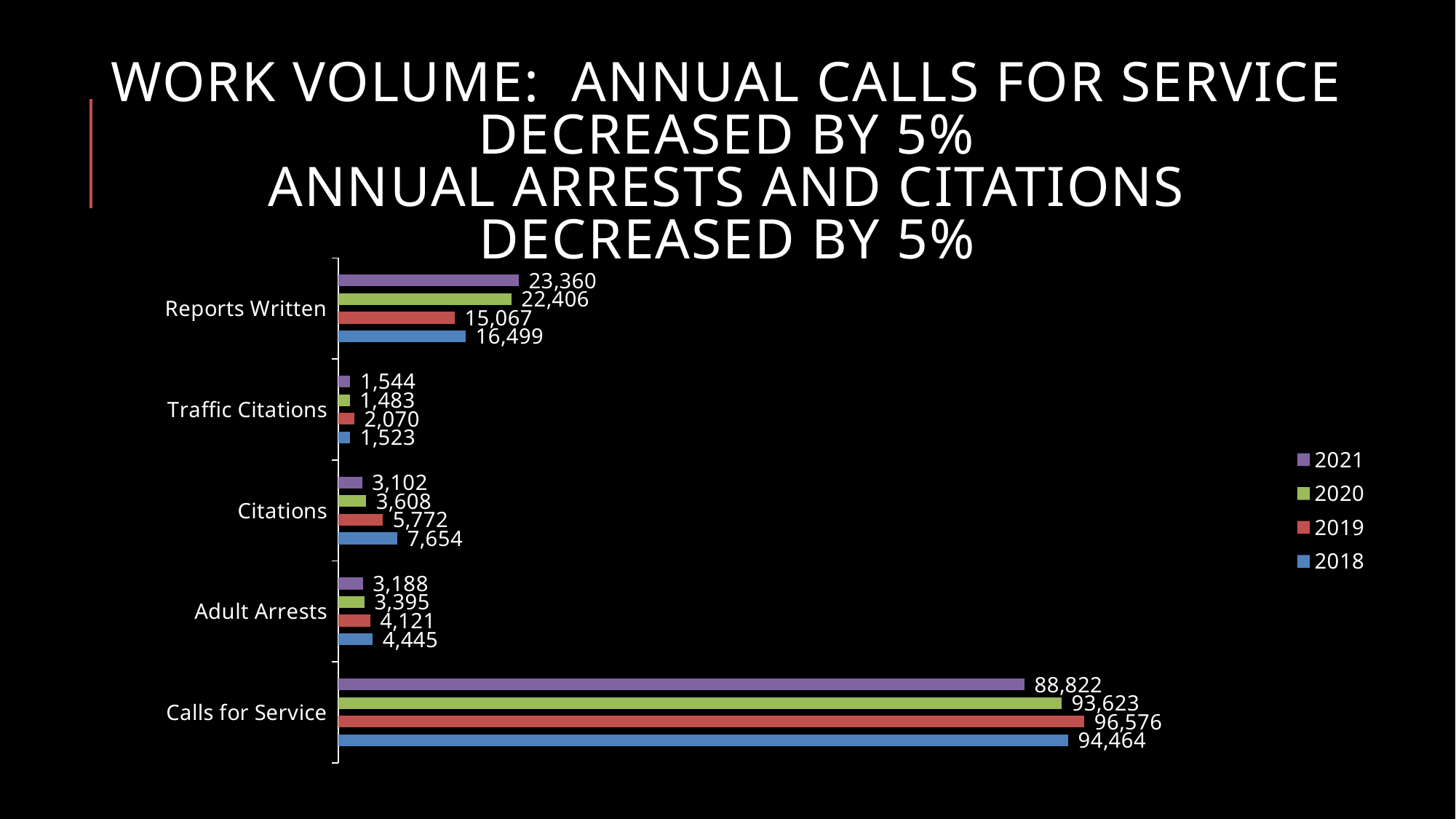
What was the value for Traffic Citations in 2018? 1,523 Which is larger: Citations in 2018 or Citations in 2019? Citations in 2018 What kind of chart is shown on the slide? Bar chart How many categories are shown on the chart? 5 What was the value for Adult Arrests in 2020? 3,395 Which year had the highest value for Calls for Service? 2019 What is the difference between Calls for Service in 2019 and in 2021? 7,754 What was the value for Calls for Service in 2021? 88,822 Which year had the lowest value for Citations? 2021 What was the value for Reports Written in 2019? 15,067 How many series does the legend list? 4 What is the difference between Reports Written in 2021 and in 2020? 954